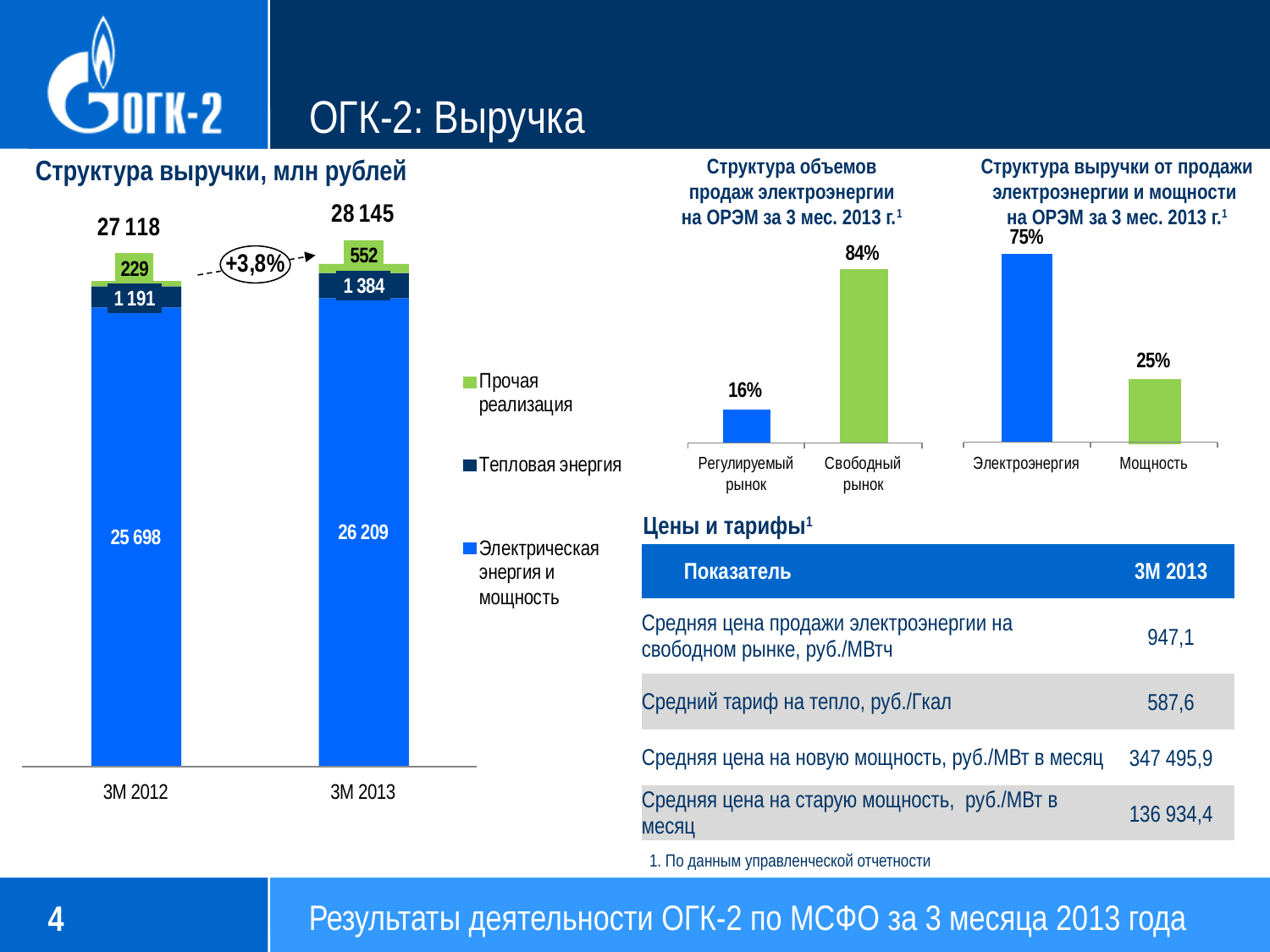
In the chart 'Структура объемов продаж электроэнергии на ОРЭМ за 3 мес. 2013 г.', which category has the lowest value? Регулируемый рынок In the chart 'Структура выручки, млн рублей', what percentage change between 3M 2012 and 3M 2013 is shown on the slide? +3,8% In the chart 'Структура выручки, млн рублей', what is the value of 'Прочая реализация' for 3M 2013? 552 In the chart 'Структура выручки, млн рублей', what is the value of 'Тепловая энергия' for 3M 2012? 1 191 In the chart 'Структура выручки, млн рублей', what is the value of 'Электрическая энергия и мощность' for 3M 2013? 26 209 In the chart 'Структура выручки, млн рублей', what is the total of the stacked bar for 3M 2012? 27 118 In the chart 'Структура выручки, млн рублей', what is the difference between the 'Прочая реализация' values for 3M 2013 and 3M 2012? 323 In the chart 'Структура выручки от продажи электроэнергии и мощности на ОРЭМ за 3 мес. 2013 г.', what is the value for 'Мощность'? 25% In the chart 'Структура объемов продаж электроэнергии на ОРЭМ за 3 мес. 2013 г.', what is the value for 'Свободный рынок'? 84% What kind of chart is 'Структура объемов продаж электроэнергии на ОРЭМ за 3 мес. 2013 г.'? Bar chart In the chart 'Структура выручки от продажи электроэнергии и мощности на ОРЭМ за 3 мес. 2013 г.', what is the difference between 'Электроэнергия' and 'Мощность'? 50% How many series does the legend of the chart 'Структура выручки, млн рублей' list? 3